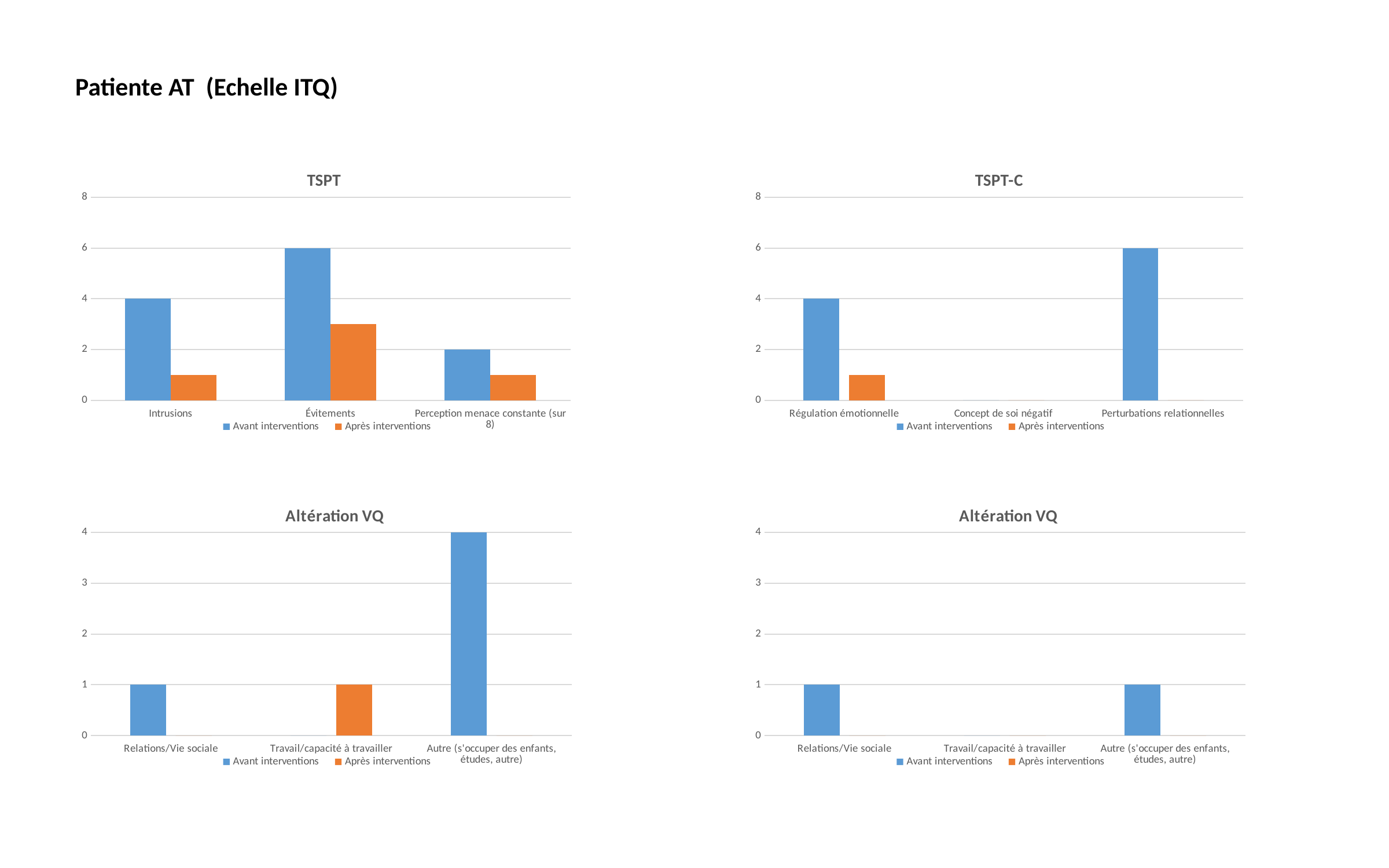
In the TSPT-C chart, is the Après interventions value for Régulation émotionnelle greater or less than 2? less In the TSPT-C chart, what is the Avant interventions value for Perturbations relationnelles? 6 In the TSPT chart, which category has the highest Avant interventions value? Évitements How many series does the legend of the TSPT chart list? 2 In the TSPT chart, what is the value for Évitements in the Avant interventions series? 6 In the TSPT chart, is the Après interventions value for Évitements greater or less than 2? greater In the TSPT chart, what is the value for Intrusions in the Avant interventions series? 4 In the TSPT-C chart, which category has the highest Avant interventions value? Perturbations relationnelles In the bottom-right Altération VQ chart, what is the Avant interventions value for Relations/Vie sociale? 1 In the bottom-left Altération VQ chart, what is the difference between the Avant interventions values for Autre (s'occuper des enfants, études, autre) and Relations/Vie sociale? 3 In the TSPT chart, how many categories are shown on the x axis? 3 In the bottom-left Altération VQ chart, what is the Avant interventions value for Autre (s'occuper des enfants, études, autre)? 4